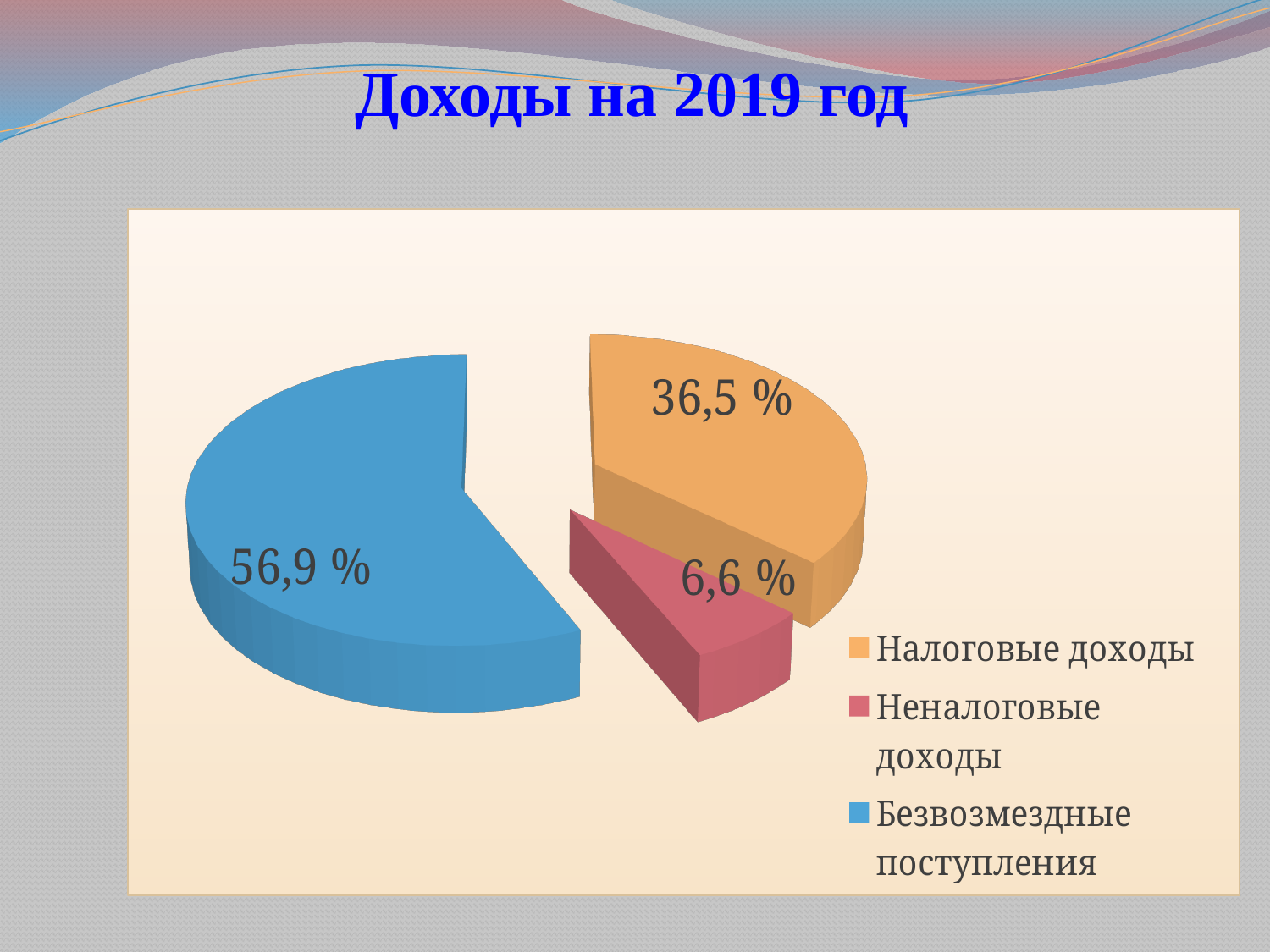
What kind of chart is shown on the slide? Pie chart What share of the pie is labelled for Безвозмездные поступления? 56,9 % Which category has the largest slice of the pie? Безвозмездные поступления What is the difference in percentage points between Налоговые доходы and Неналоговые доходы? 29,9 Which category has the smallest slice of the pie? Неналоговые доходы What share of the pie is labelled for Неналоговые доходы? 6,6 % What colour is the slice for Неналоговые доходы? Red What share of the pie is labelled for Налоговые доходы? 36,5 % How many slices does the pie chart have? 3 What is the difference in percentage points between Безвозмездные поступления and Налоговые доходы? 20,4 What is the title of the slide? Доходы на 2019 год Which is larger, the slice for Налоговые доходы or the slice for Неналоговые доходы? Налоговые доходы